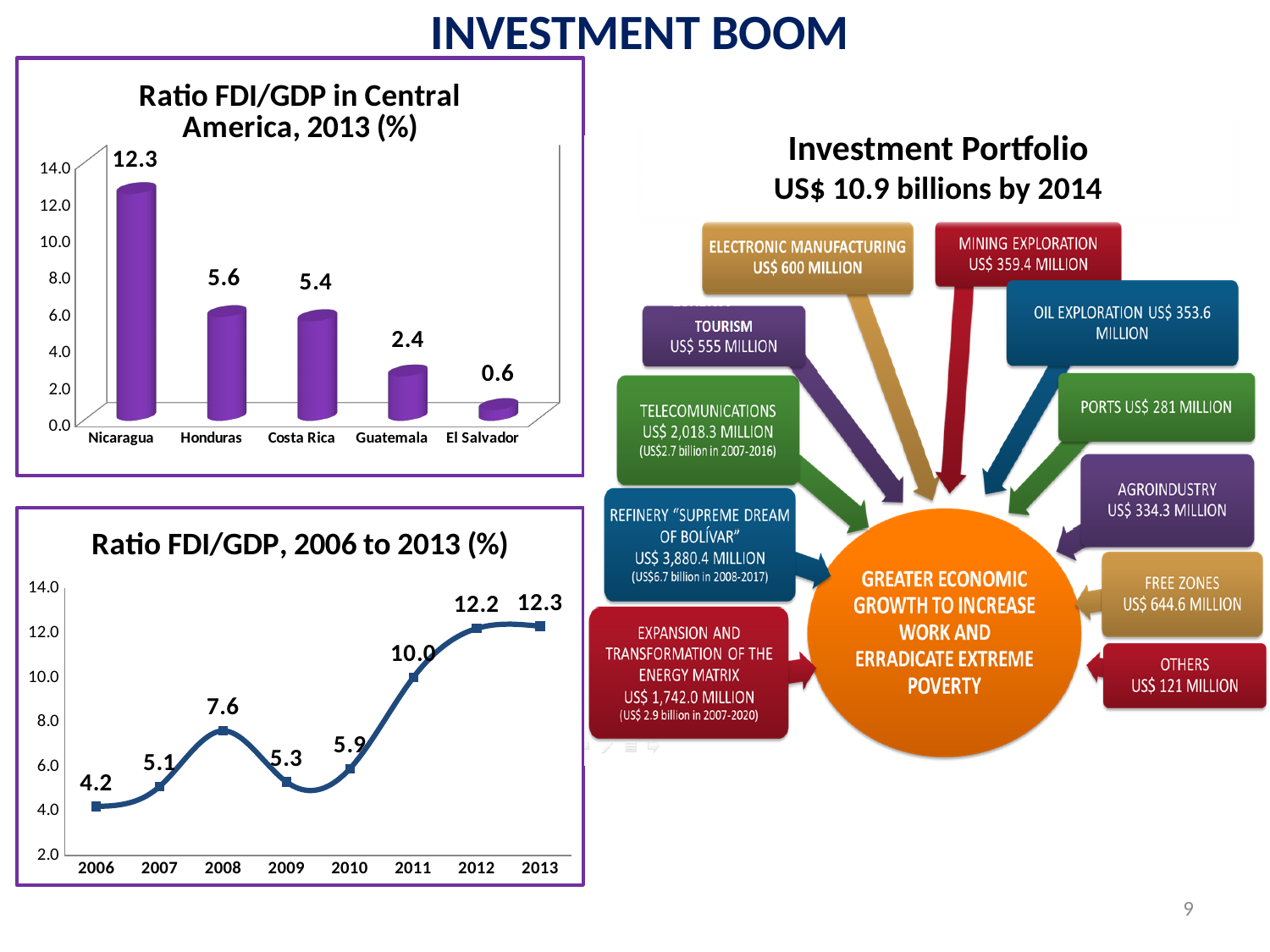
In the 'Ratio FDI/GDP in Central America, 2013 (%)' chart, what is the value for Guatemala? 2.4 In the 'Ratio FDI/GDP in Central America, 2013 (%)' chart, which country has the lowest value? El Salvador In the 'Ratio FDI/GDP, 2006 to 2013 (%)' chart, what is the difference between 2013 and 2006? 8.1 In the 'Ratio FDI/GDP in Central America, 2013 (%)' chart, what is the value for Nicaragua? 12.3 In the 'Ratio FDI/GDP, 2006 to 2013 (%)' chart, which is larger, the value for 2009 or the value for 2011? 2011 What kind of chart is 'Ratio FDI/GDP, 2006 to 2013 (%)'? Line chart In the 'Ratio FDI/GDP in Central America, 2013 (%)' chart, how many countries are shown? 5 In the 'Ratio FDI/GDP, 2006 to 2013 (%)' chart, which year has the lowest value? 2006 In the 'Ratio FDI/GDP, 2006 to 2013 (%)' chart, how many years are plotted? 8 What kind of chart is 'Ratio FDI/GDP in Central America, 2013 (%)'? Bar chart In the 'Ratio FDI/GDP in Central America, 2013 (%)' chart, what is the difference between Nicaragua and Honduras? 6.7 In the 'Ratio FDI/GDP, 2006 to 2013 (%)' chart, what is the value for 2008? 7.6